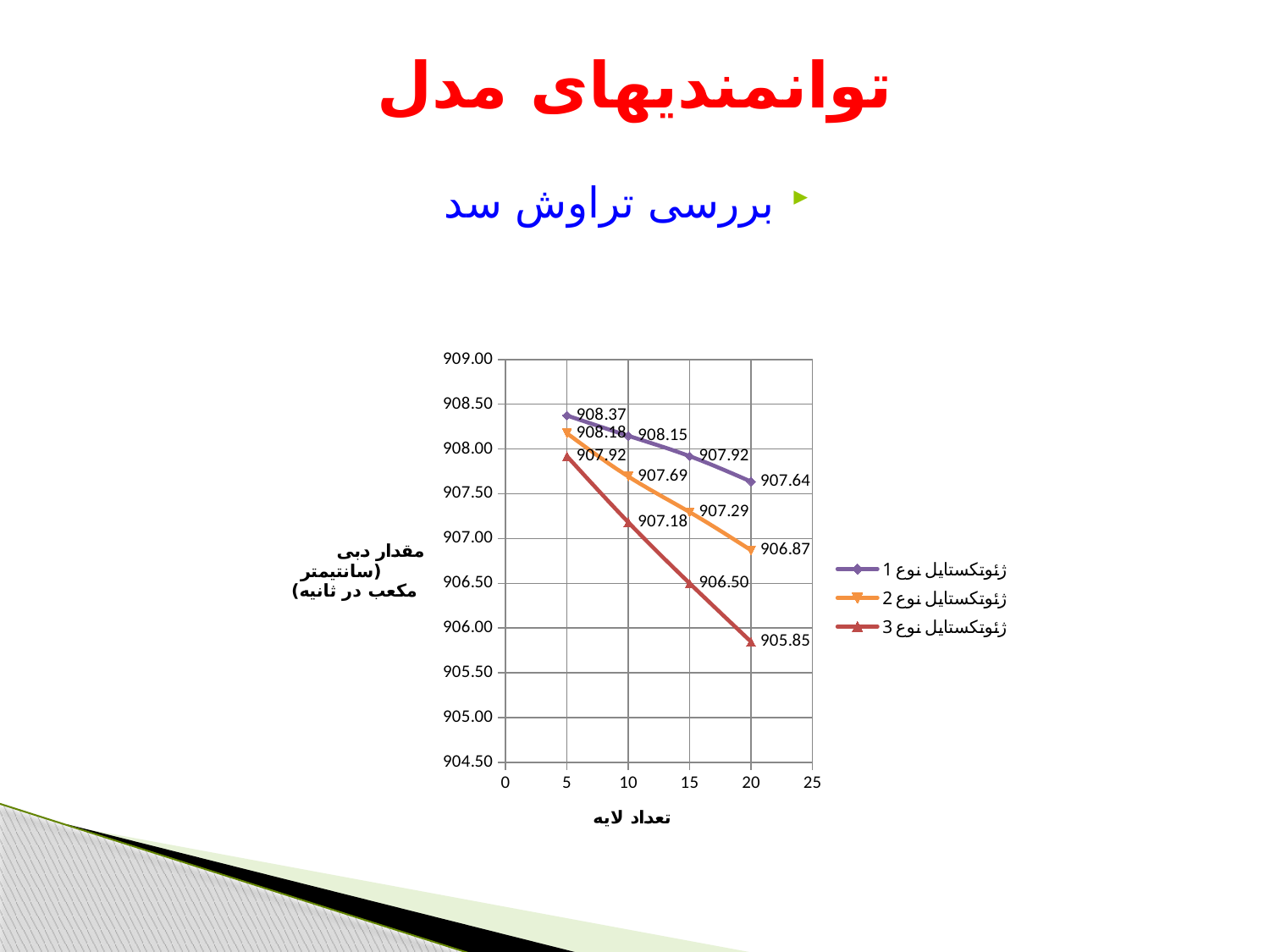
Which is larger at 10 layers: the value for ژئوتکستایل نوع 2 or ژئوتکستایل نوع 3? ژئوتکستایل نوع 2 How many data points are plotted for each series? 4 What is the value for ژئوتکستایل نوع 2 at 15 layers (تعداد لایه = 15)? 907.29 What is the value for ژئوتکستایل نوع 3 at 20 layers (تعداد لایه = 20)? 905.85 What is the value for ژئوتکستایل نوع 1 at 5 layers (تعداد لایه = 5)? 908.37 What is the difference between the values of ژئوتکستایل نوع 1 and ژئوتکستایل نوع 3 at 20 layers? 1.79 Which series has the lowest value at 20 layers? ژئوتکستایل نوع 3 What is the value for ژئوتکستایل نوع 1 at 20 layers (تعداد لایه = 20)? 907.64 How many series does the legend list? 3 Which series has the highest value at 5 layers? ژئوتکستایل نوع 1 Do the values for ژئوتکستایل نوع 3 rise or fall as the number of layers increases? fall What type of chart is shown on the slide? line chart